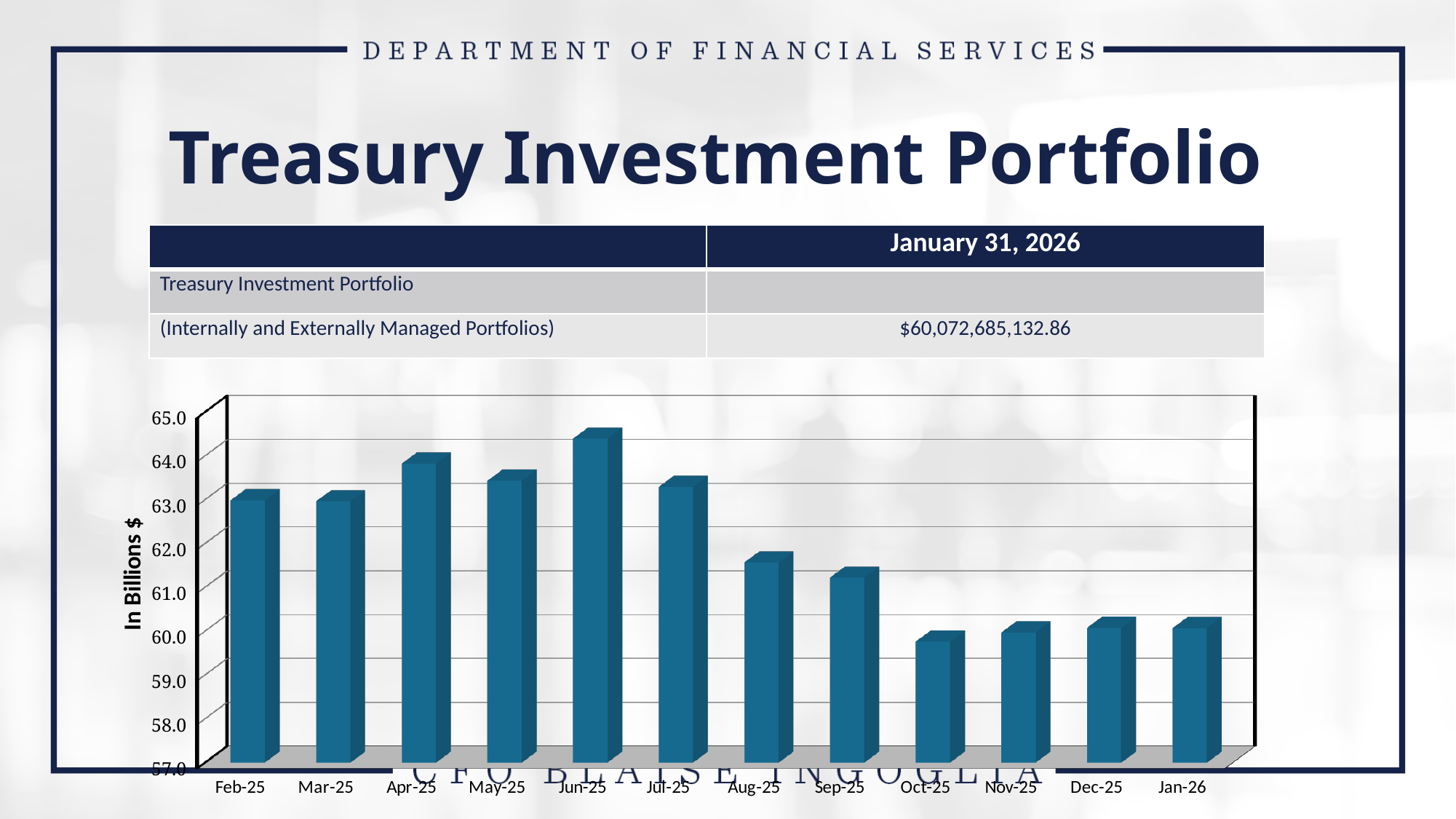
How many months are plotted on the chart? 12 What is the label on the vertical axis of the chart? In Billions $ Is the value for Feb-25 greater or less than 62.0? greater What kind of chart is shown on the slide? bar chart Overall, do the values rise or fall from Feb-25 to Jan-26? fall Is the value for Jun-25 greater or less than 64.0? greater Which is larger, the value for Sep-25 or the value for Dec-25? Sep-25 Which is larger, the value for Jun-25 or the value for Jul-25? Jun-25 Is the value for Aug-25 greater or less than 62.0? less Which month has the highest value on the chart? Jun-25